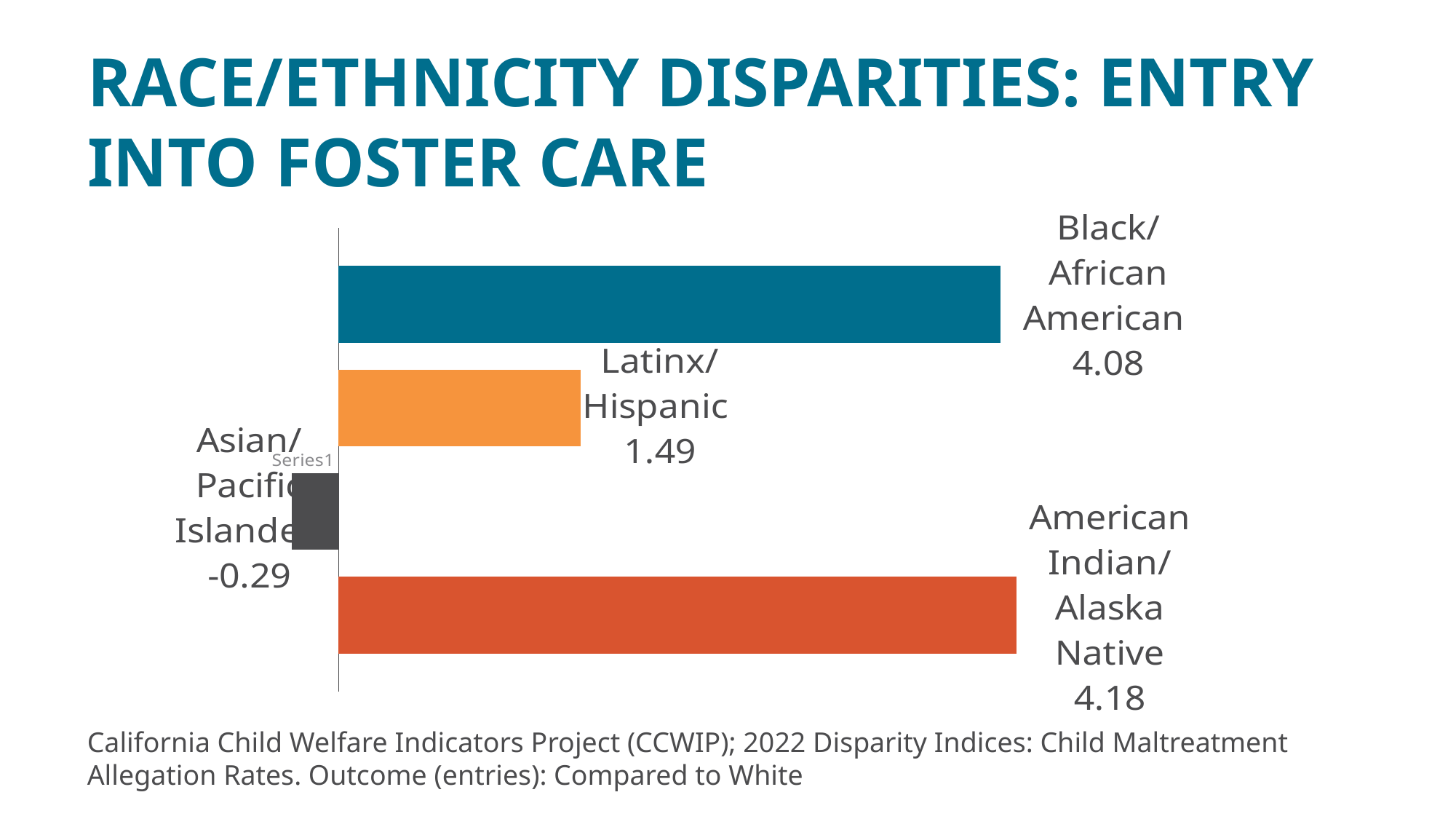
Which is larger, the value for Black/African American or the value for Latinx/Hispanic? Black/African American What is the title of the slide? RACE/ETHNICITY DISPARITIES: ENTRY INTO FOSTER CARE What is the value for Asian/Pacific Islander? -0.29 What is the value for Latinx/Hispanic? 1.49 How many categories are shown in the chart? 4 What kind of chart is shown on the slide? Bar chart What is the value for Black/African American? 4.08 Which category has the highest value? American Indian/Alaska Native What is the difference between the values for Black/African American and Latinx/Hispanic? 2.59 What is the value for American Indian/Alaska Native? 4.18 What is the difference between the values for American Indian/Alaska Native and Black/African American? 0.10 Which category has the lowest value? Asian/Pacific Islander